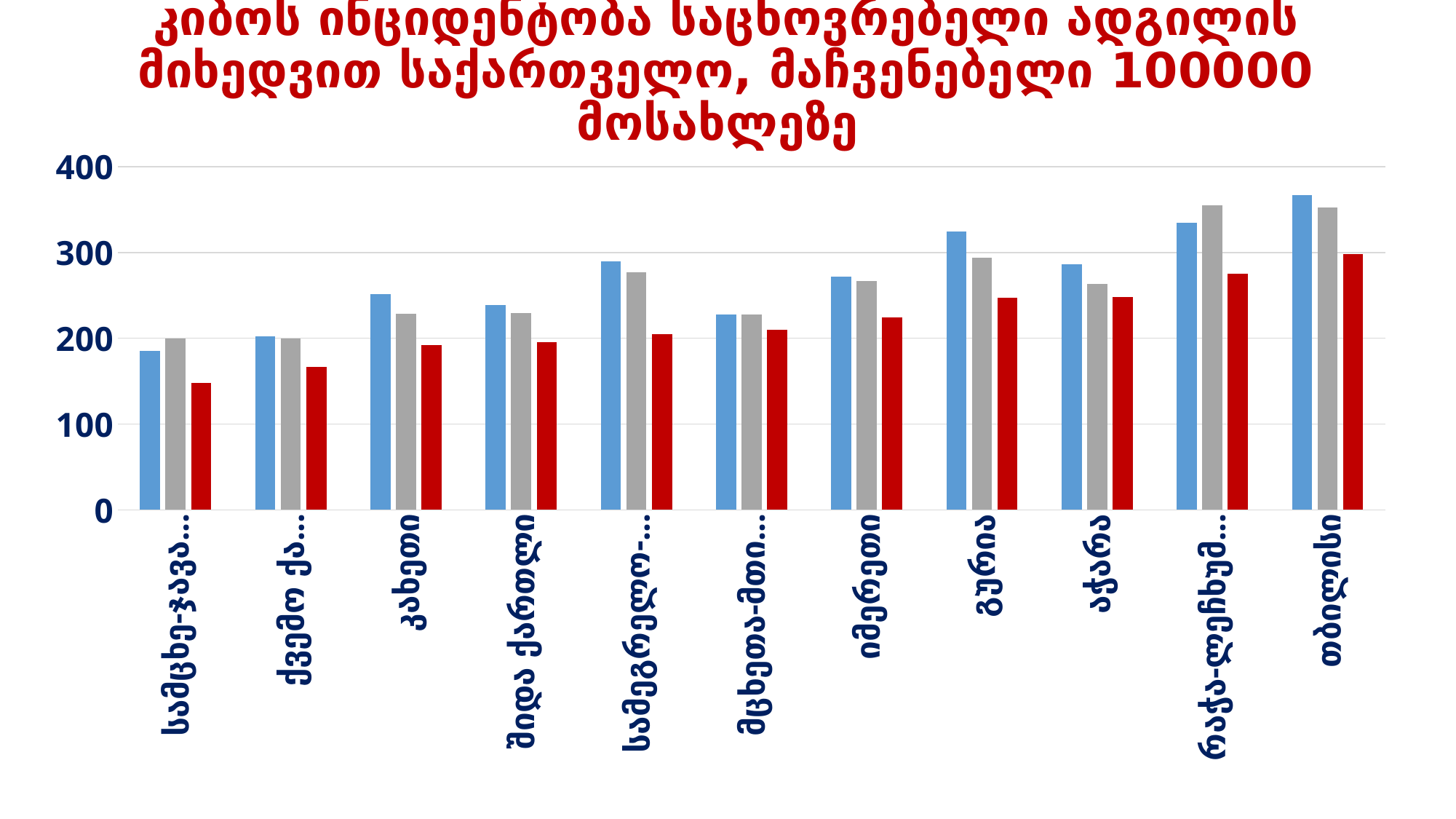
In the კახეთი group, which bar is taller, the blue one or the red one? blue How many bars are plotted for each category in the chart? 3 Is the blue bar for კახეთი greater or less than 200? greater Which category has the tallest red bar? თბილისი Is the red bar for გურია greater or less than 300? less What kind of chart is shown on the slide? bar chart Do the red bars generally rise or fall from left to right across the categories? rise Which category has the tallest blue bar? თბილისი How many categories are shown along the x axis of the chart? 11 Is the gray bar for აჭარა greater or less than 300? less Which is larger, the blue bar for გურია or the blue bar for აჭარა? გურია